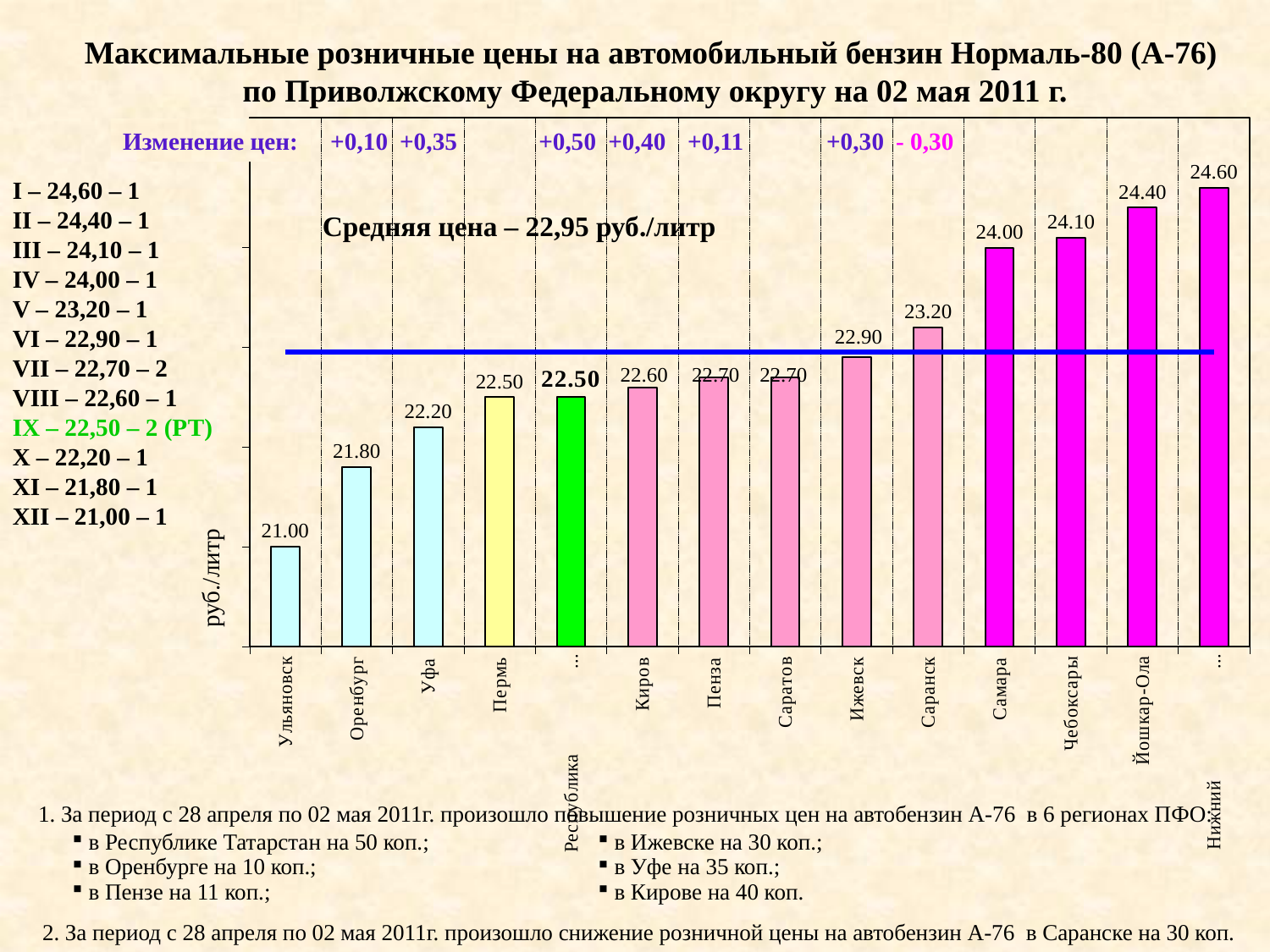
What is the difference between the values for Йошкар-Ола and Самара? 0.40 How many bars are plotted in the chart? 14 Which category has the lowest value? Ульяновск What is the value for Саранск? 23.20 What average price is stated on the chart? 22,95 руб./литр Do the values rise or fall from left to right along the x axis? rise Which category has the highest value? Нижний What is the value for Чебоксары? 24.10 What is the value for Ижевск? 22.90 What is the value for Ульяновск? 21.00 What kind of chart is shown on the slide? bar chart Which is larger, the value for Оренбург or the value for Уфа? Уфа